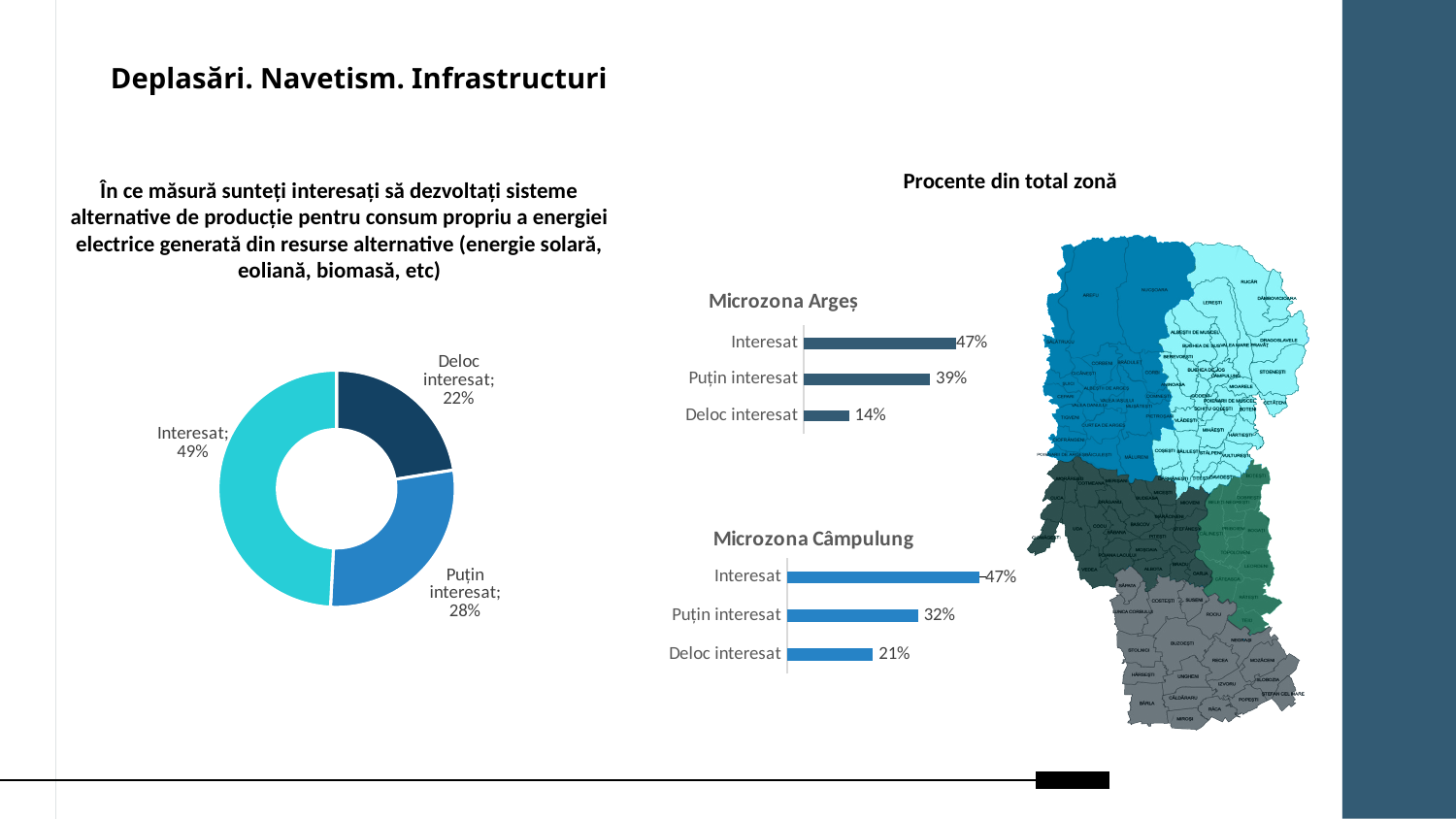
In the donut chart on the left, which category has the largest share? Interesat In the 'Microzona Câmpulung' chart, which is larger, 'Puțin interesat' or 'Deloc interesat'? Puțin interesat In the 'Microzona Argeș' chart, what is the difference between 'Interesat' and 'Deloc interesat'? 33 percentage points What is the title above the two bar charts on the right side of the slide? Procente din total zonă In the donut chart on the left, what percentage of respondents are 'Deloc interesat'? 22% In the donut chart on the left, what percentage of respondents are 'Interesat'? 49% In the 'Microzona Argeș' chart, what is the value for 'Puțin interesat'? 39% In the donut chart on the left, how many categories are shown? 3 In the 'Microzona Câmpulung' chart, what is the value for 'Deloc interesat'? 21% What kind of chart is 'Microzona Câmpulung'? Bar chart Which chart has the higher value for 'Puțin interesat', 'Microzona Argeș' or 'Microzona Câmpulung'? Microzona Argeș In the 'Microzona Argeș' chart, which category has the lowest value? Deloc interesat